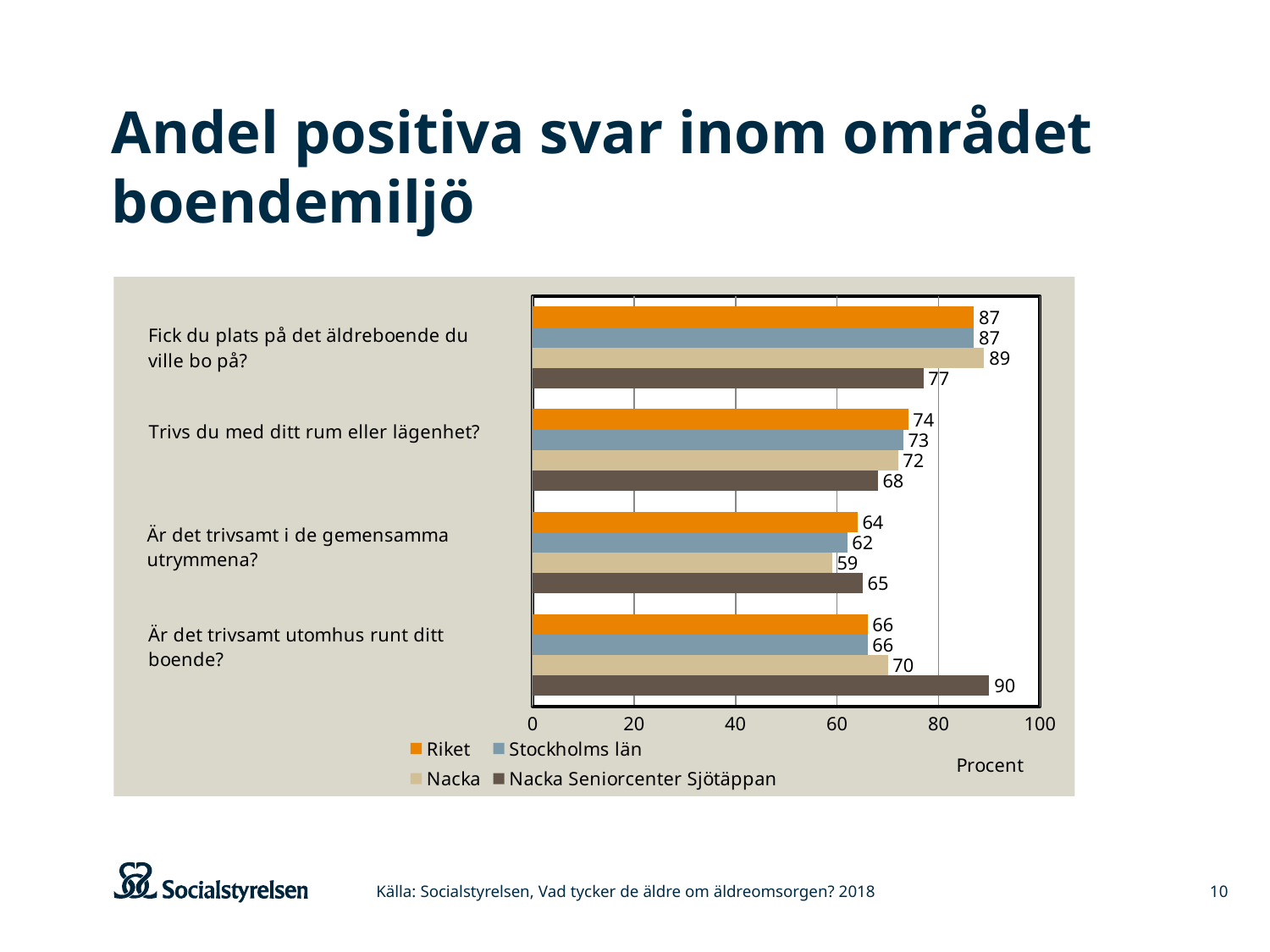
What is the value for Nacka on "Fick du plats på det äldreboende du ville bo på?"? 89 What is the value for Stockholms län on "Är det trivsamt i de gemensamma utrymmena?"? 62 How many series does the legend list? 4 Which is larger on "Fick du plats på det äldreboende du ville bo på?": Nacka or Nacka Seniorcenter Sjötäppan? Nacka Which series has the lowest value on "Är det trivsamt i de gemensamma utrymmena?"? Nacka How many question categories are shown on the chart? 4 What is the difference between Nacka Seniorcenter Sjötäppan and Riket on "Är det trivsamt utomhus runt ditt boende?"? 24 What is the value for Nacka Seniorcenter Sjötäppan on "Är det trivsamt utomhus runt ditt boende?"? 90 What kind of chart is shown on the slide? Bar chart Which series has the highest value on "Är det trivsamt utomhus runt ditt boende?"? Nacka Seniorcenter Sjötäppan What unit label is shown below the x axis of the chart? Procent What is the value for Riket on "Trivs du med ditt rum eller lägenhet?"? 74